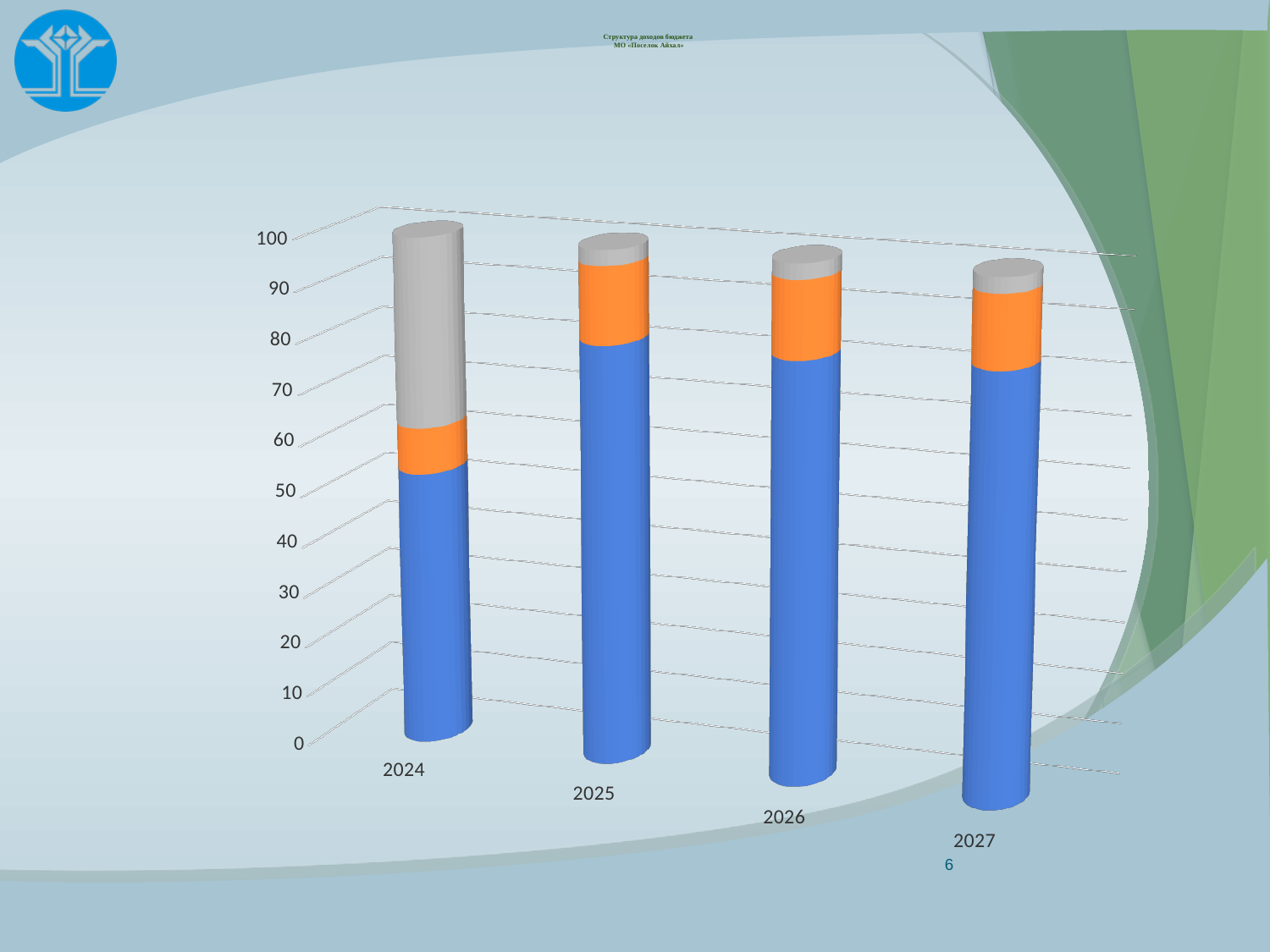
Is the blue segment for 2025 greater or less than 50? greater What kind of chart is shown on the slide? Stacked bar chart Which is larger, the blue segment for 2024 or the blue segment for 2025? 2025 In which year is the grey segment of the stacked bar the largest? 2024 How many years (categories) are shown on the x axis of the chart? 4 Which years are shown on the x axis of the chart? 2024, 2025, 2026, 2027 Is the blue segment for 2026 greater or less than 50? greater What is the highest value shown on the vertical axis of the chart? 100 In which year is the blue segment of the stacked bar the smallest? 2024 Which is larger, the grey segment for 2024 or the grey segment for 2027? 2024 How many differently coloured segments make up each stacked bar? 3